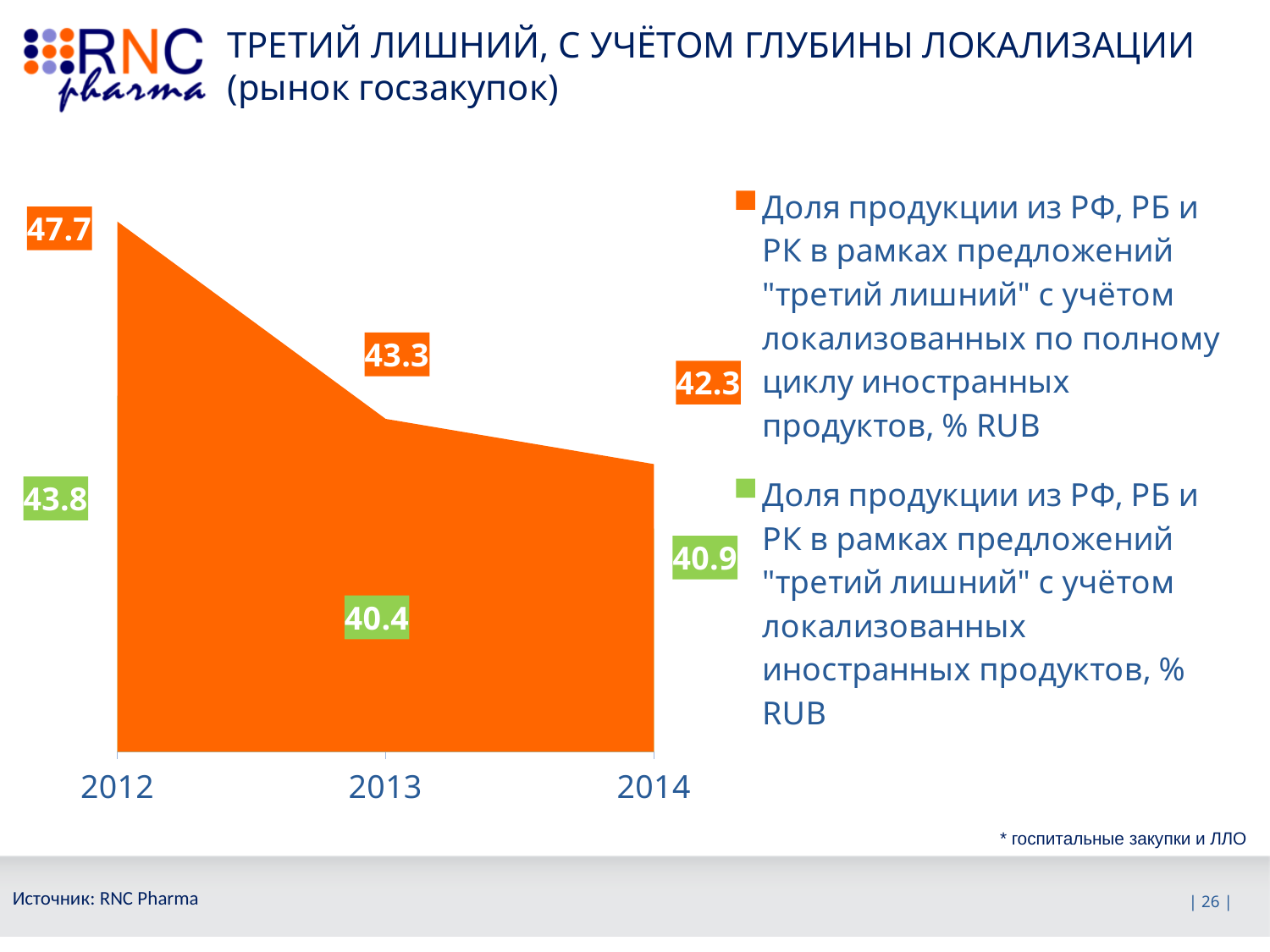
What is the difference between the orange and green series values in 2012? 3.9 What is the value of the green series (localized foreign products) in 2013? 40.4 What is the difference between the orange series values in 2012 and 2013? 4.4 How many years are shown on the x axis? 3 How many series does the legend list? 2 In which year is the orange series (full-cycle localization) highest? 2012 In which year is the green series lowest? 2013 What is the value of the orange series in 2014? 42.3 What kind of chart is shown on the slide? Area chart Which is larger in 2014: the orange series value or the green series value? Orange series (42.3) What is the value of the orange series (localized by full cycle) in 2012? 47.7 What is the value of the green series in 2014? 40.9